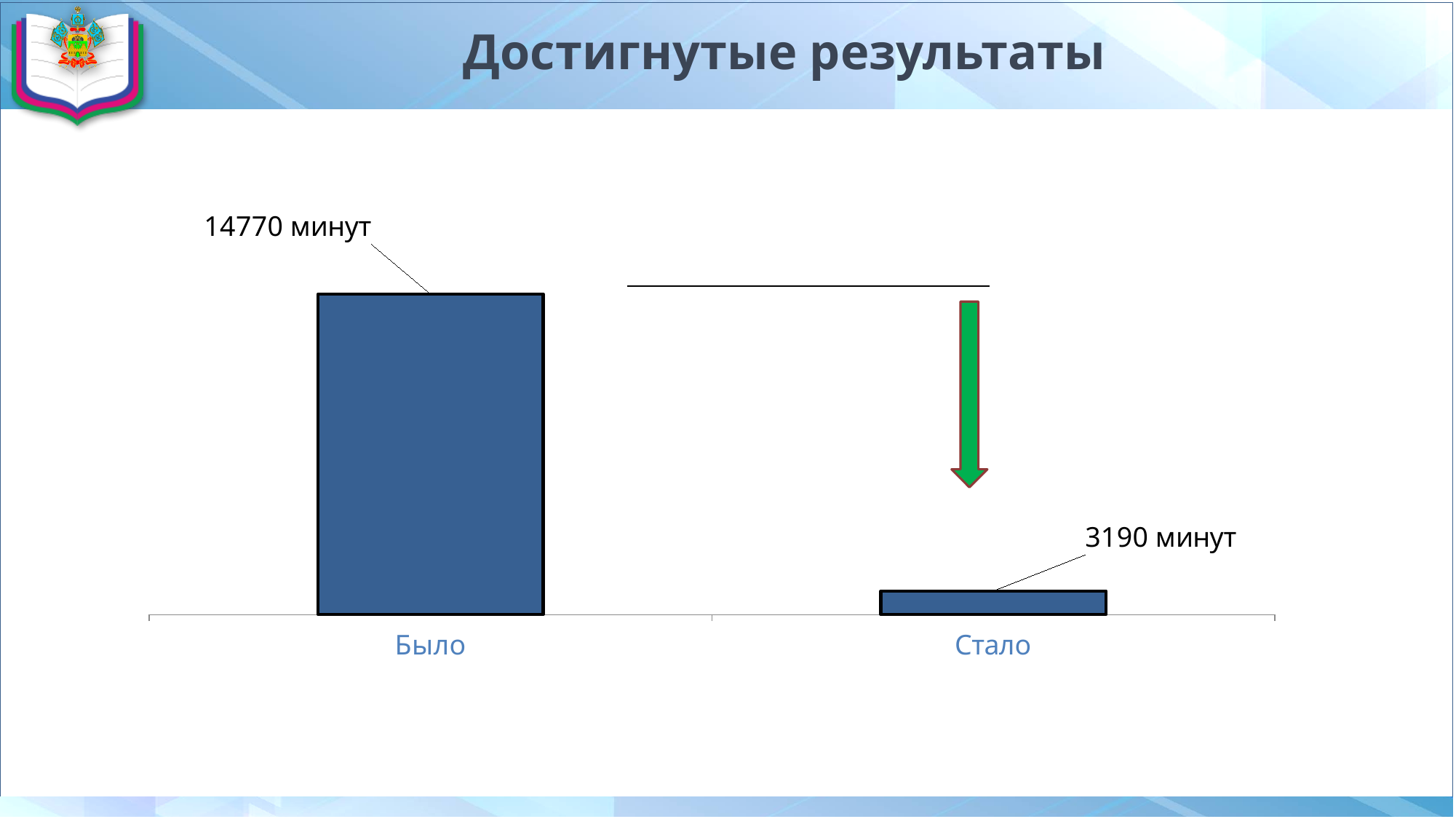
Which category has the lowest value? Стало What is the value for Стало? 3190 минут Which category has the highest value? Было Do the values rise or fall from Было to Стало? Fall How many categories are shown on the chart? 2 What kind of chart is shown on the slide? Bar chart What is the difference between the values for Было and Стало? 11580 минут What is the value for Было? 14770 минут What colour are the bars in the chart? Blue What is the title of the slide containing the chart? Достигнутые результаты Which is larger, the value for Было or the value for Стало? Было